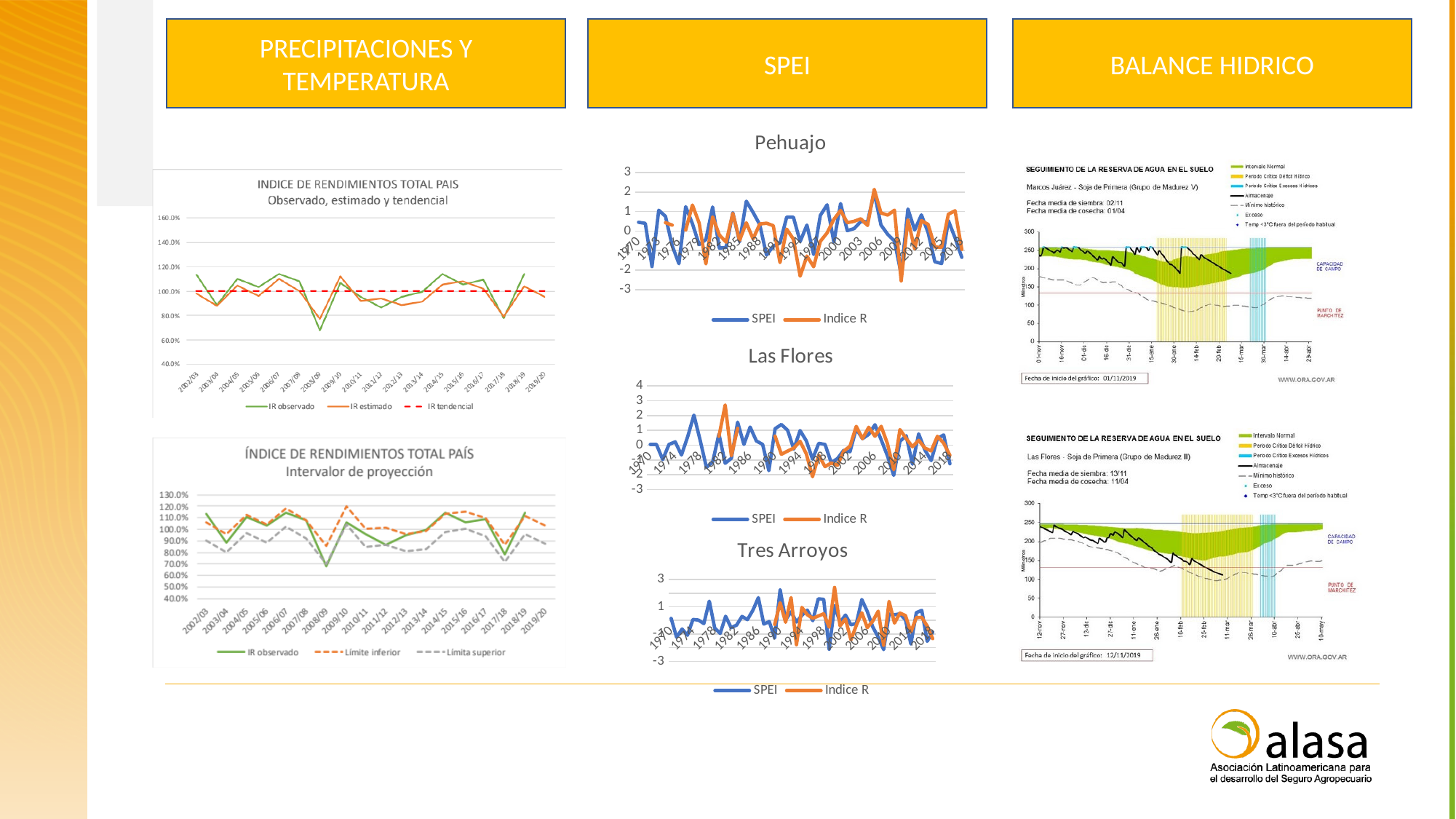
In the chart titled 'ÍNDICE DE RENDIMIENTOS TOTAL PAÍS Intervalor de proyección', which season has the lowest IR observado value? 2008/09 What is the highest value shown on the y axis of the Las Flores chart in the SPEI column? 4 What kind of chart is the Pehuajo chart in the SPEI column? line chart In the chart titled 'ÍNDICE DE RENDIMIENTOS TOTAL PAÍS Intervalor de proyección', is the IR observado value for 2008/09 greater or less than 80.0%? less In the chart titled 'INDICE DE RENDIMIENTOS TOTAL PAIS Observado, estimado y tendencial', is the IR observado value for 2008/09 greater or less than 80.0%? less What kind of chart is the chart titled 'ÍNDICE DE RENDIMIENTOS TOTAL PAÍS Intervalor de proyección'? line chart What is the highest value shown on the y axis of the Tres Arroyos chart? 3 In the chart titled 'INDICE DE RENDIMIENTOS TOTAL PAIS Observado, estimado y tendencial', at what level does the IR tendencial line sit? 100.0% What are the two legend entries of the Las Flores chart in the SPEI column? SPEI and Indice R How many series does the legend of the chart titled 'ÍNDICE DE RENDIMIENTOS TOTAL PAÍS Intervalor de proyección' list? 3 How many series does the legend of the Pehuajo chart list? 2 In the chart titled 'INDICE DE RENDIMIENTOS TOTAL PAIS Observado, estimado y tendencial', which season has the lowest IR observado value? 2008/09